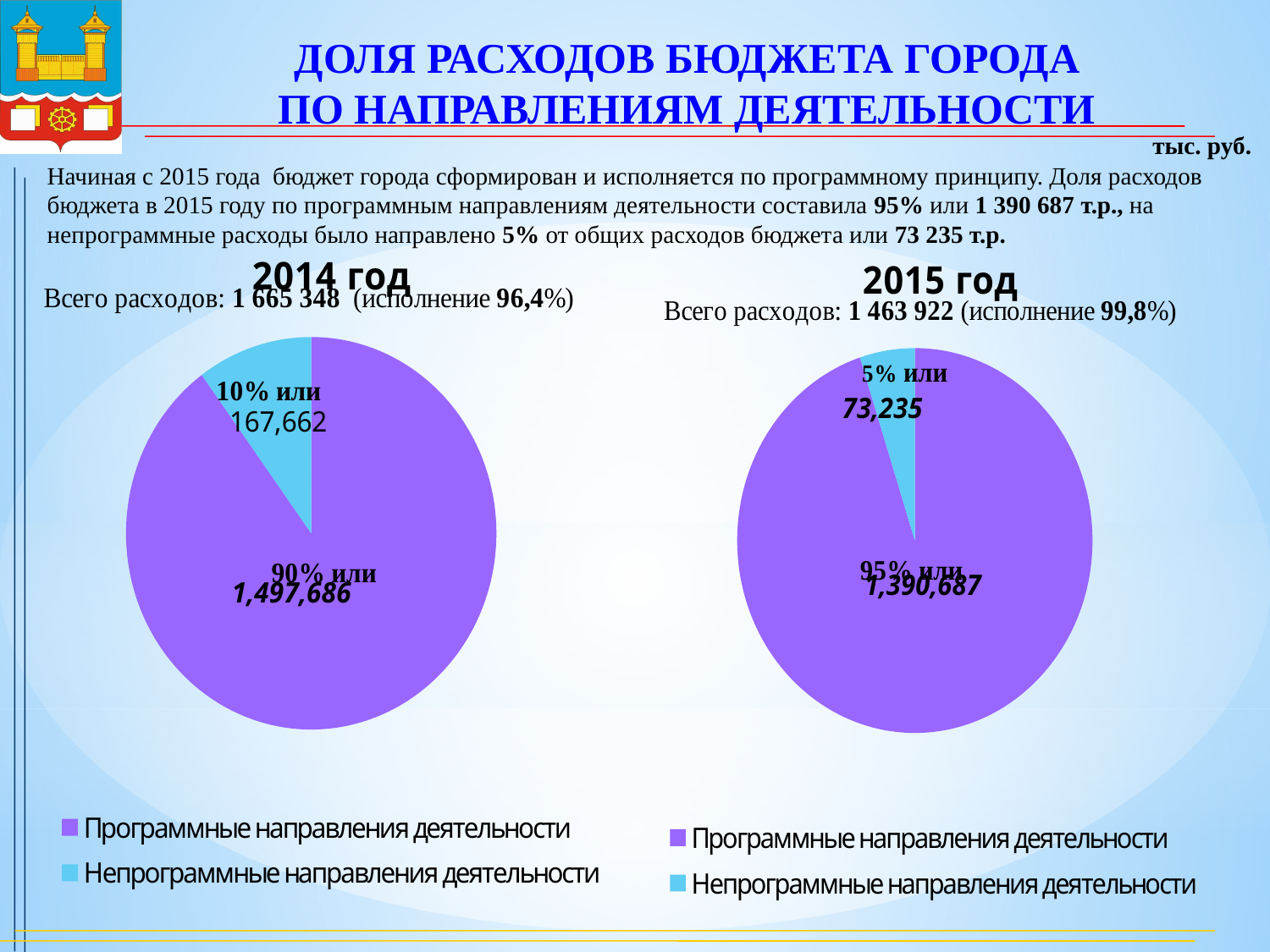
In the 2014 год chart, which category has the largest slice? Программные направления деятельности In the 2015 год chart, what share of the pie is Программные направления деятельности? 95% In the 2014 год chart, what is the value for Непрограммные направления деятельности? 167,662 How many slices does the 2014 год pie chart have? 2 In the 2015 год chart, what is the difference between Программные направления деятельности and Непрограммные направления деятельности? 1,317,452 In the 2014 год chart, what share of the pie is Непрограммные направления деятельности? 10% In the 2015 год chart, which category has the smallest slice? Непрограммные направления деятельности In the 2015 год chart, what colour is the slice for Непрограммные направления деятельности? light blue In the 2015 год chart, what is the value for Программные направления деятельности? 1,390,687 In the 2014 год chart, what is the value for Программные направления деятельности? 1,497,686 What type of chart is used for the 2014 год data? pie chart In the 2015 год chart, what is the value for Непрограммные направления деятельности? 73,235